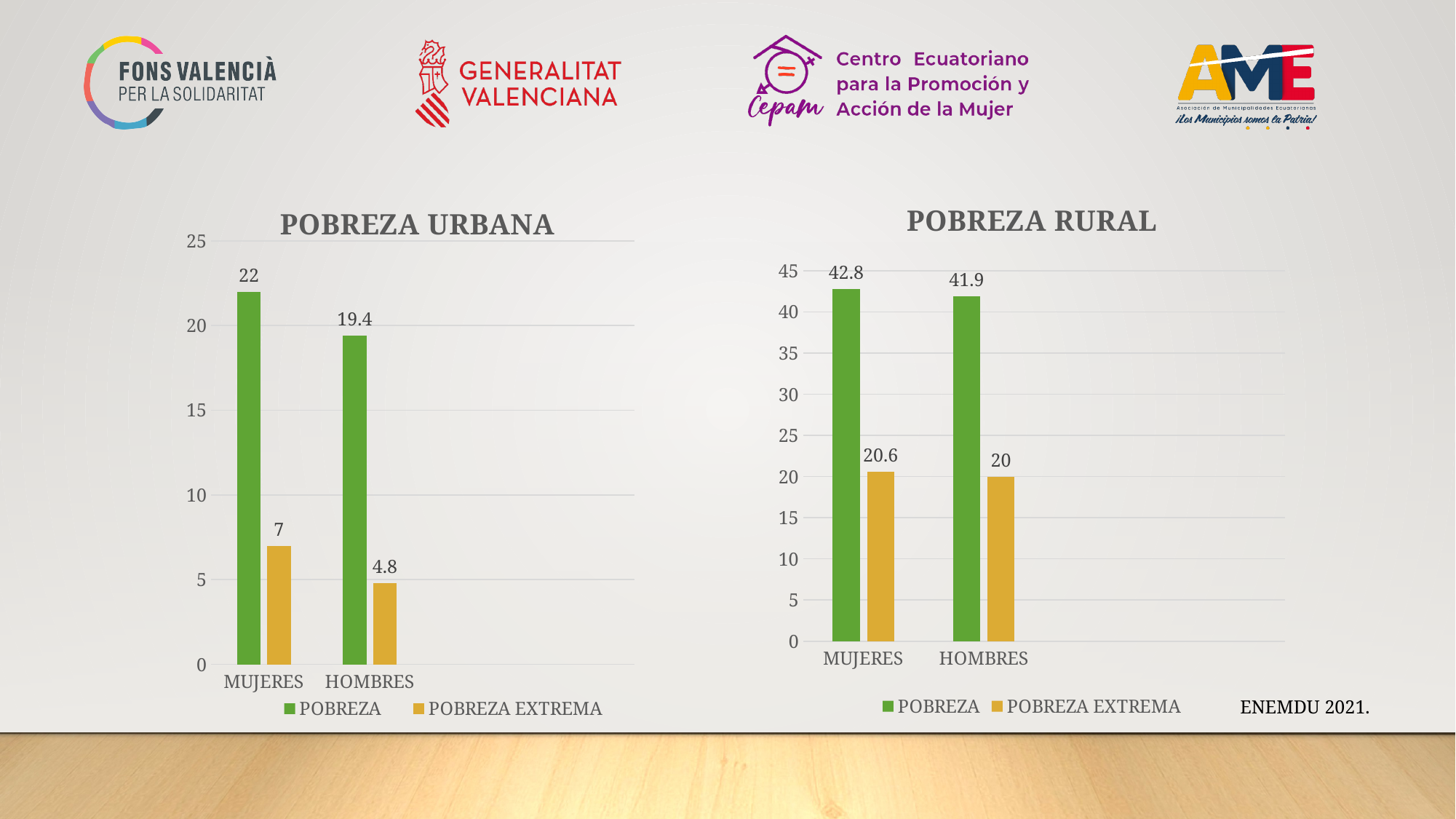
In the POBREZA RURAL chart, which category has the lowest POBREZA EXTREMA value? HOMBRES In the POBREZA RURAL chart, what is the difference between the POBREZA EXTREMA values for MUJERES and HOMBRES? 0.6 In the POBREZA URBANA chart, what is the POBREZA value for MUJERES? 22 In the POBREZA RURAL chart, what is the POBREZA EXTREMA value for MUJERES? 20.6 In the POBREZA URBANA chart, what is the difference between the POBREZA values for MUJERES and HOMBRES? 2.6 In the POBREZA RURAL chart, what is the POBREZA value for HOMBRES? 41.9 In the POBREZA URBANA chart, what is the POBREZA EXTREMA value for HOMBRES? 4.8 In the POBREZA URBANA chart, which category has the higher POBREZA EXTREMA value, MUJERES or HOMBRES? MUJERES In the POBREZA URBANA chart, which bar is the highest? POBREZA for MUJERES How many categories are shown on the x axis of the POBREZA URBANA chart? 2 How many series does the legend of the POBREZA RURAL chart list? 2 What kind of chart is the POBREZA RURAL chart? Bar chart